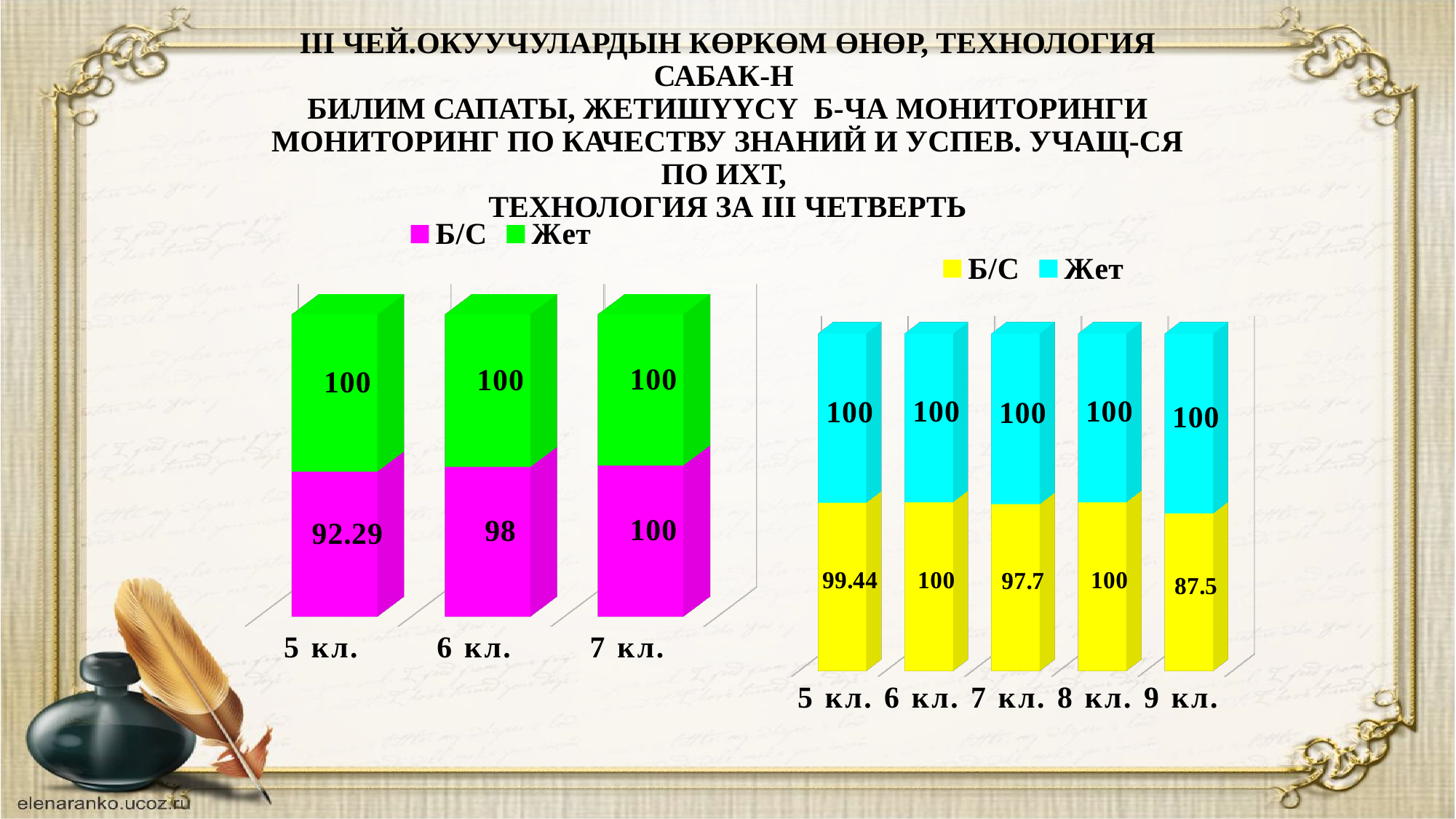
In the right chart, which class has the lowest Б/С value? 9 кл. What type of chart is the right chart? stacked bar chart In the left chart, what is the Б/С value for 6 кл.? 98 In the left chart, what is the Жет value for 7 кл.? 100 In the left chart, how many classes are shown on the x axis? 3 In the right chart, how many series does the legend list? 2 In the right chart, what is the Б/С value for 7 кл.? 97.7 In the left chart, what is the Б/С value for 5 кл.? 92.29 In the right chart, what is the Б/С value for 9 кл.? 87.5 In the left chart, which class has the lowest Б/С value? 5 кл. In the left chart, what is the difference between the Б/С values for 7 кл. and 5 кл.? 7.71 In the right chart, is the Б/С value for 5 кл. larger or smaller than the Б/С value for 7 кл.? larger